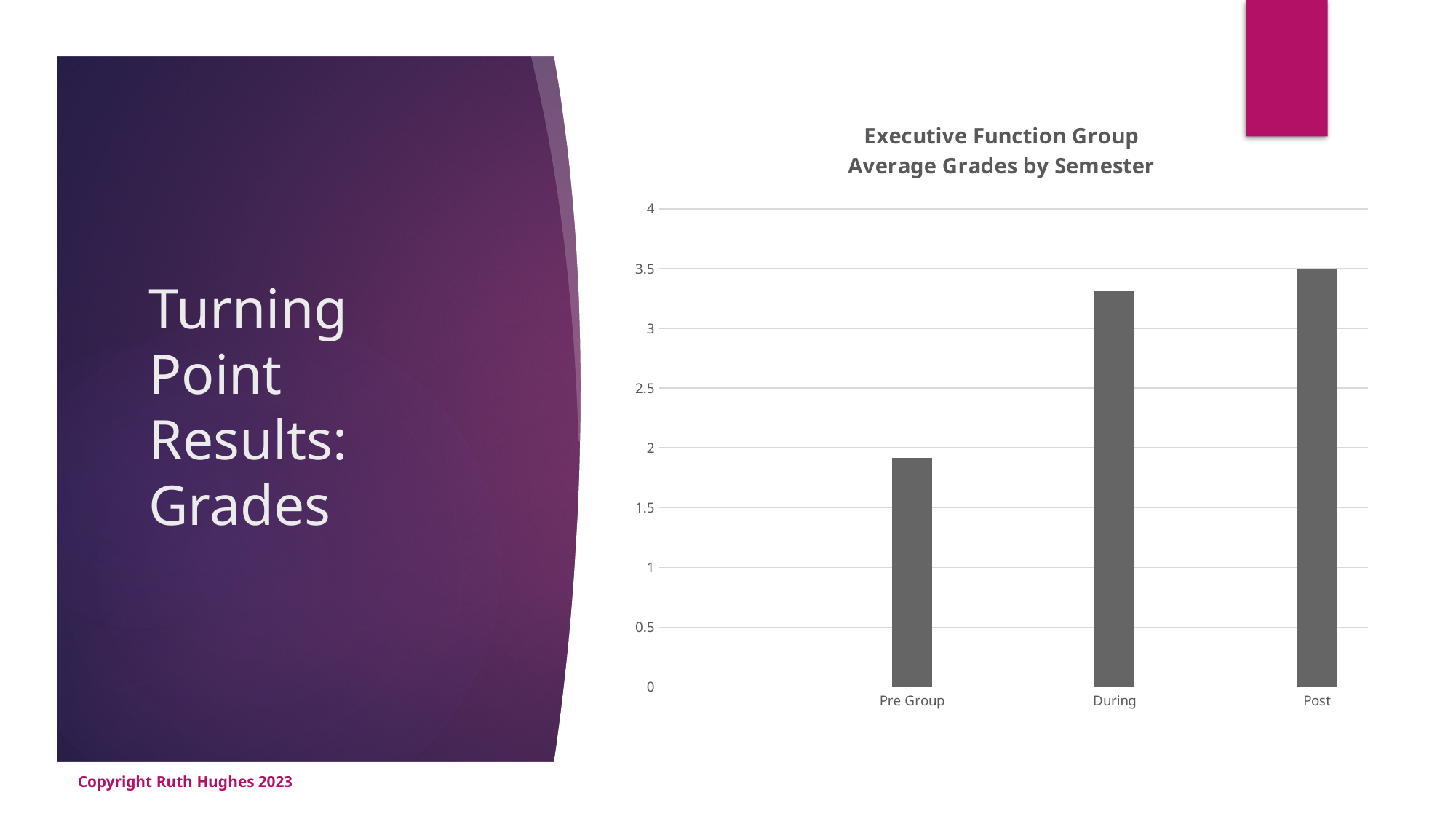
Is the value for Pre Group greater or less than 2? less What kind of chart is shown on the slide? bar chart How many categories are shown on the x axis of the chart? 3 Which category has the lowest average grade? Pre Group Which category has the highest average grade? Post Which is larger, the value for Pre Group or the value for During? During Is the value for Pre Group greater or less than 1.5? greater Do the values rise or fall from Pre Group to Post along the x axis? rise Is the value for During greater or less than 3.5? less What is the highest value shown on the chart's vertical axis? 4 What is the title of the chart? Executive Function Group Average Grades by Semester